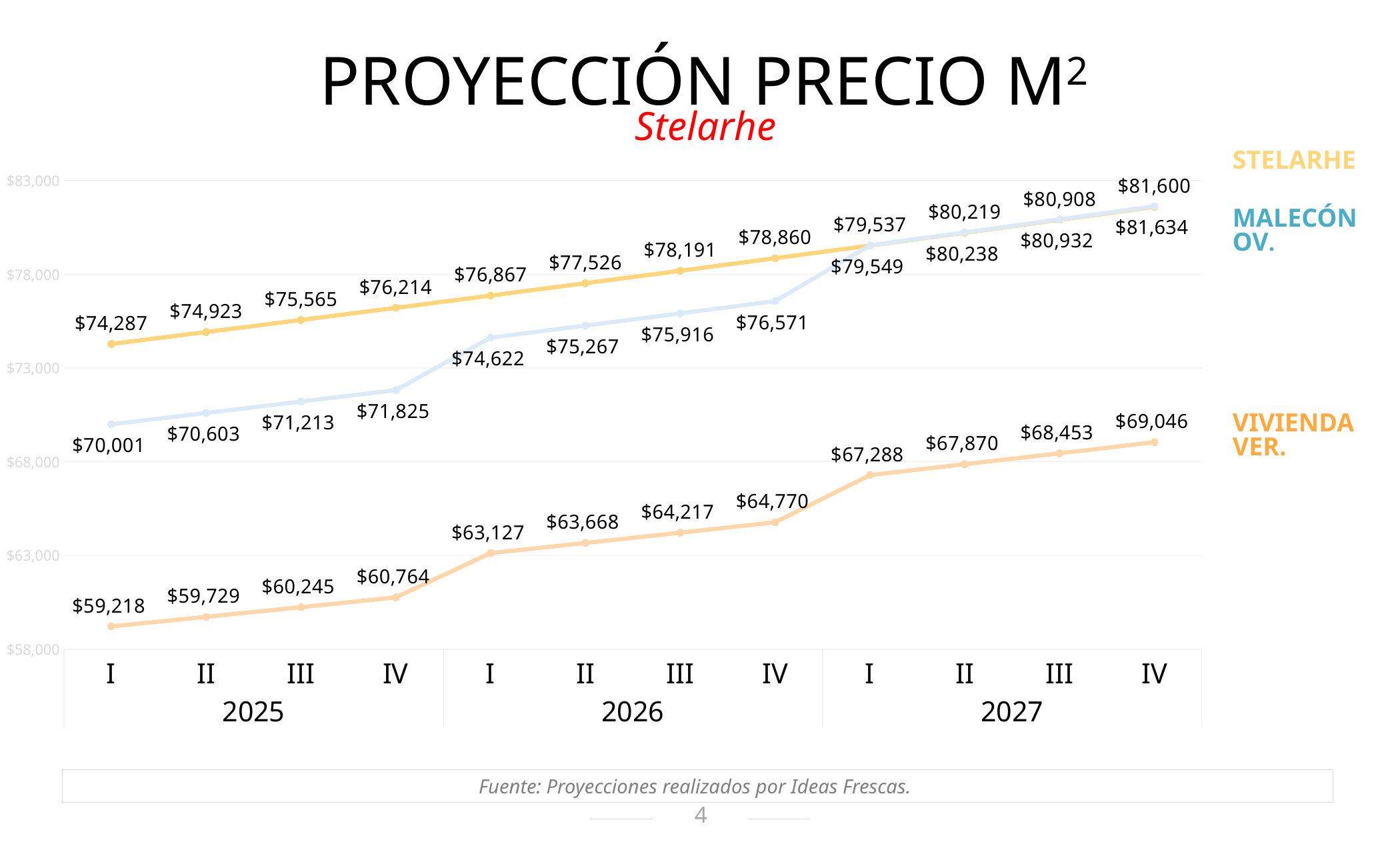
How many series does the chart show? 3 What is the projected price per m² for VIVIENDA VER. in quarter IV of 2027? $69,046 Which is larger in quarter IV of 2026: the STELARHE value or the MALECÓN OV. value? STELARHE How many quarters are plotted along the x axis? 12 Is the value for VIVIENDA VER. in quarter I of 2027 greater or less than $68,000? less What is the projected price per m² for STELARHE in quarter III of 2026? $78,191 Which series has the highest value in quarter IV of 2025? STELARHE What is the projected price per m² for STELARHE in quarter I of 2025? $74,287 What kind of chart is shown on the slide? Line chart What is the projected price per m² for MALECÓN OV. in quarter I of 2026? $74,622 Which series has the lowest value in quarter I of 2025? VIVIENDA VER. What is the difference between the STELARHE and VIVIENDA VER. values in quarter I of 2025? $15,069